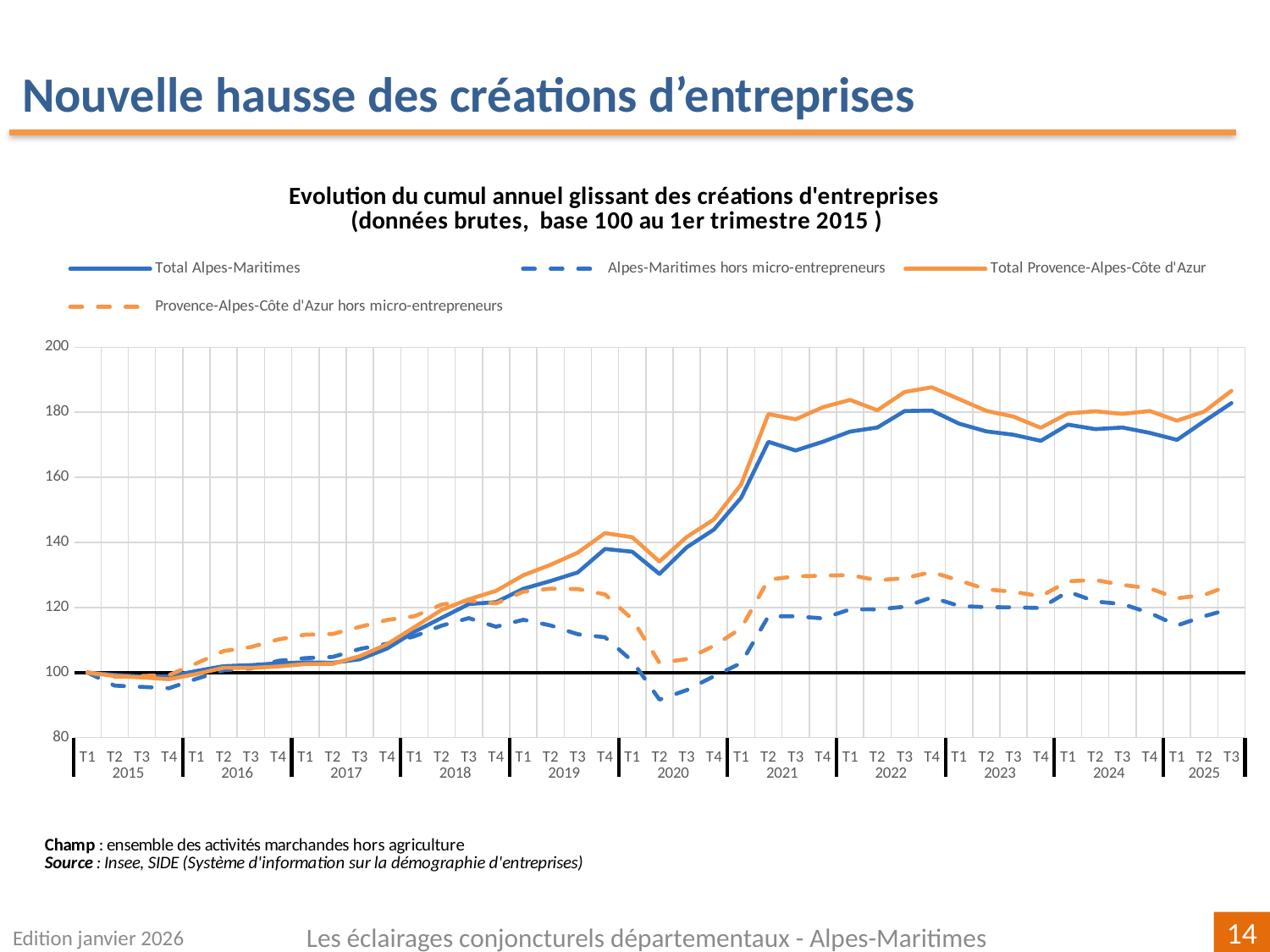
How many years are labelled on the x axis? 11 What kind of chart is shown on the slide? line chart Is the value for Provence-Alpes-Côte d'Azur hors micro-entrepreneurs at T3 2025 greater or less than 120? greater Is the value for Alpes-Maritimes hors micro-entrepreneurs at T2 2020 greater or less than 100? less At T4 2022, which is higher: Total Provence-Alpes-Côte d'Azur or Total Alpes-Maritimes? Total Provence-Alpes-Côte d'Azur Which colour is used for the Provence-Alpes-Côte d'Azur series? orange How many series does the legend list? 4 What is the title of the chart? Evolution du cumul annuel glissant des créations d'entreprises (données brutes, base 100 au 1er trimestre 2015 ) Overall, does the Total Alpes-Maritimes series rise or fall from T1 2015 to T3 2025? rise Is the value for Total Alpes-Maritimes at T1 2025 greater or less than 180? less What is the value of the Total Alpes-Maritimes series at T1 2015? 100